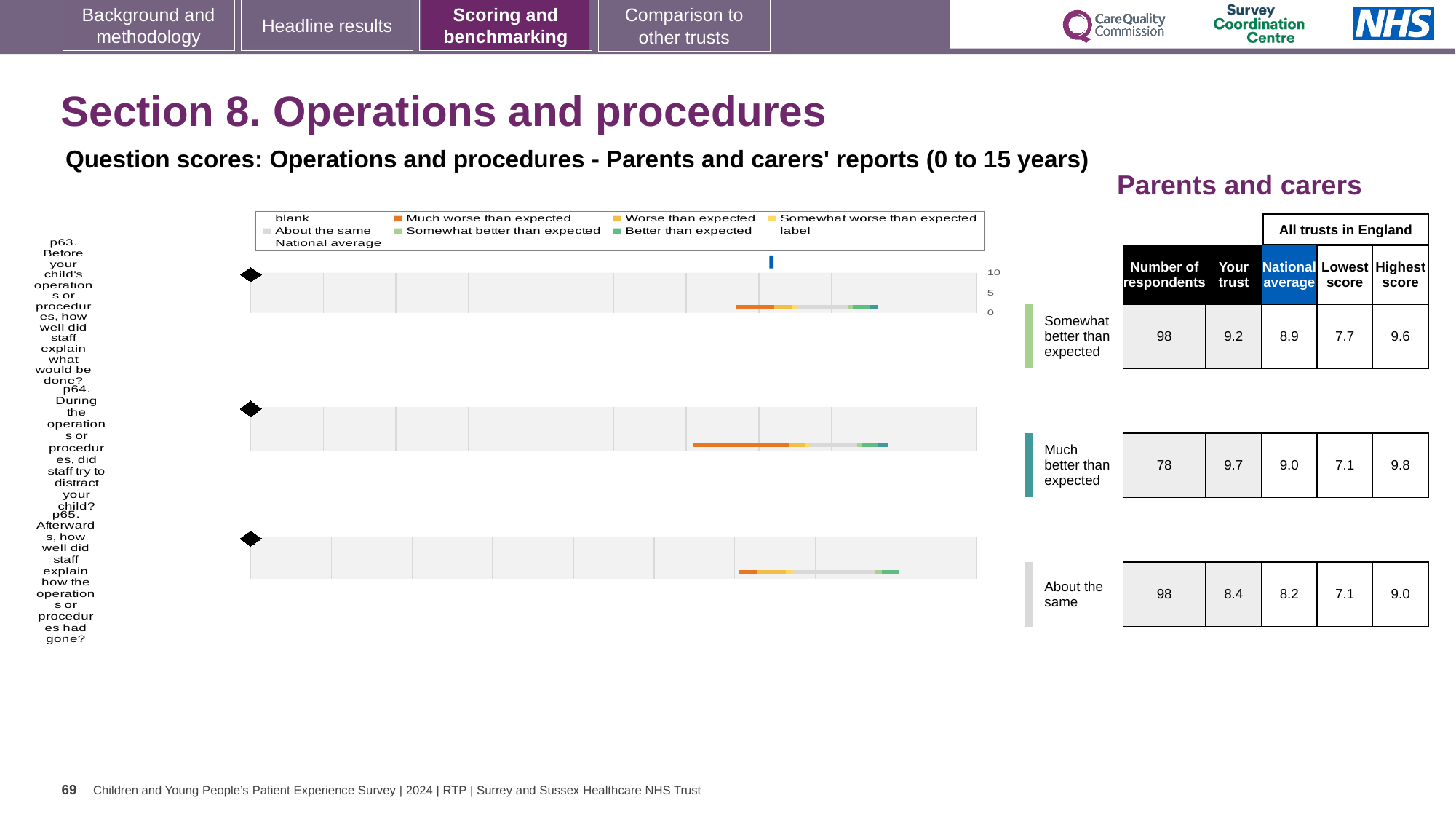
What is the 'Your trust' score for p63 (how well staff explained what would be done before the operation)? 9.2 For p65, is the 'Your trust' score higher or lower than the national average? higher Which question has the fewest respondents? p64 What is the difference between the 'Your trust' score and the national average for p64? 0.7 What is the lowest score among all trusts in England for p63? 7.7 What is the national average score for p64 (did staff try to distract your child during the operation)? 9.0 What is the highest score among all trusts in England for p65? 9.0 Which question has the highest 'Your trust' score? p64 How many respondents answered p65 (how well staff explained how the operation had gone)? 98 How many questions are plotted in the chart? 3 Which question has the lowest 'Your trust' score? p65 Which benchmark category is shown for p64? Much better than expected